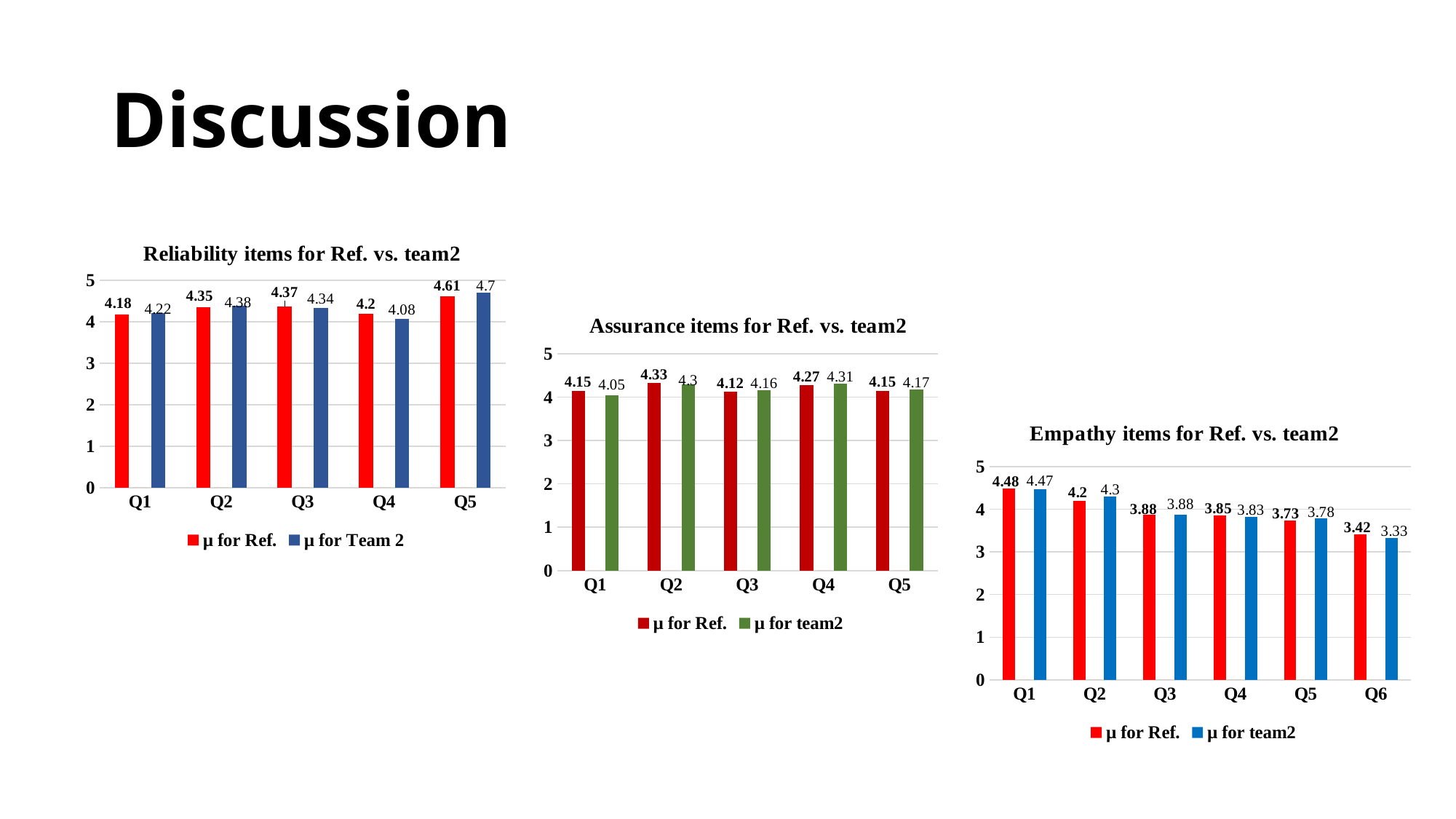
In the 'Empathy items for Ref. vs. team2' chart, how many series does the legend list? 2 What kind of chart is the 'Empathy items for Ref. vs. team2' chart? bar chart In the 'Reliability items for Ref. vs. team2' chart, what is the value of μ for Ref. at Q5? 4.61 In the 'Empathy items for Ref. vs. team2' chart, which question has the lowest μ for team2 value? Q6 In the 'Empathy items for Ref. vs. team2' chart, do the μ for Ref. values rise or fall from Q1 to Q6? fall In the 'Assurance items for Ref. vs. team2' chart, which question has the lowest μ for team2 value? Q1 In the 'Assurance items for Ref. vs. team2' chart, what is the value of μ for team2 at Q1? 4.05 In the 'Empathy items for Ref. vs. team2' chart, what is the value of μ for Ref. at Q6? 3.42 In the 'Reliability items for Ref. vs. team2' chart, what is the difference between μ for Team 2 and μ for Ref. at Q5? 0.09 In the 'Reliability items for Ref. vs. team2' chart, which question has the highest μ for Team 2 value? Q5 In the 'Reliability items for Ref. vs. team2' chart, what is the value of μ for Team 2 at Q4? 4.08 In the 'Assurance items for Ref. vs. team2' chart, how many questions are shown on the x axis? 5